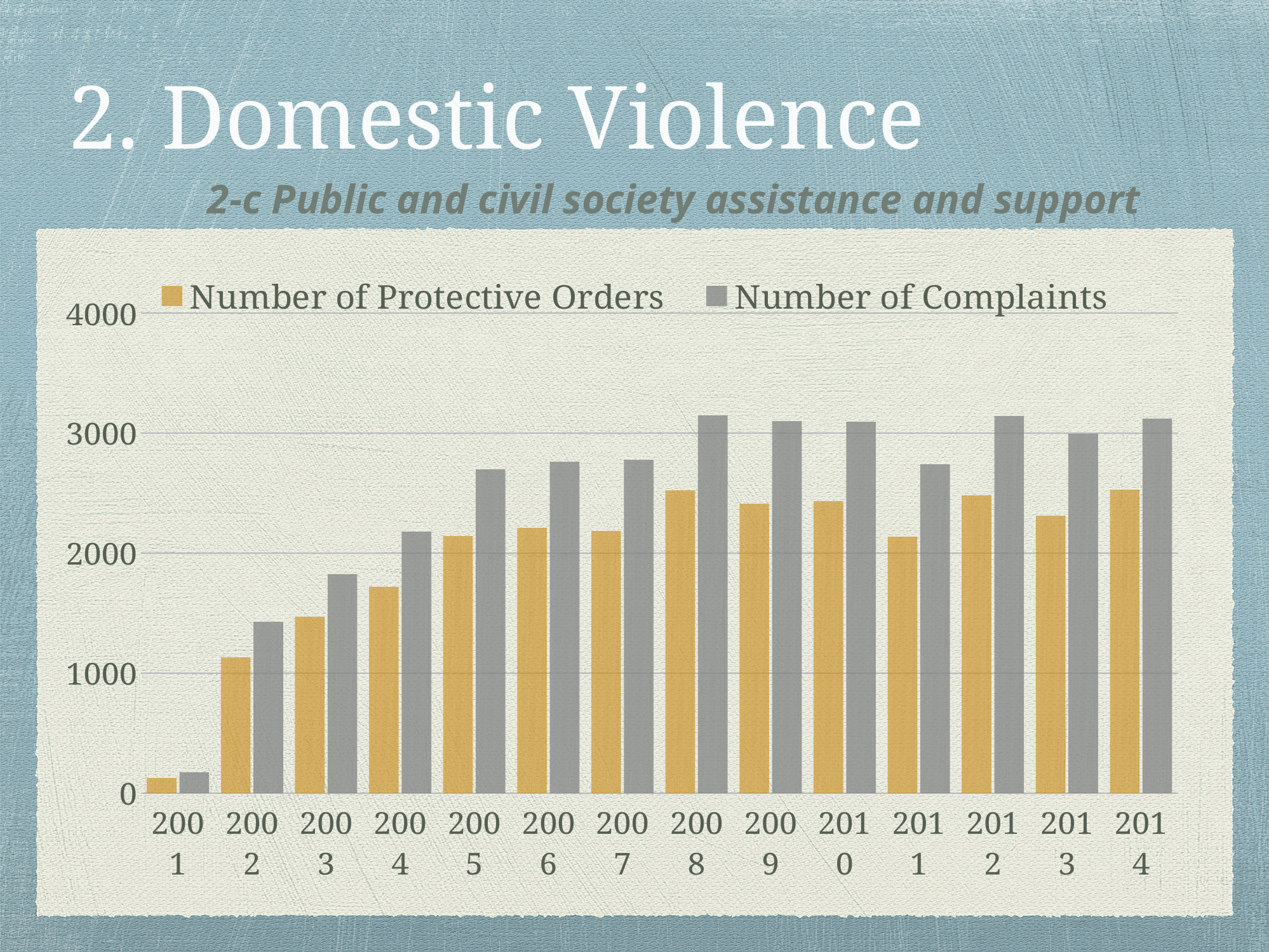
Which year has the lowest Number of Protective Orders? 2001 How many years are shown on the x axis? 14 Do the Number of Protective Orders values rise or fall from 2001 to 2005? rise Is the Number of Complaints for 2003 greater or less than 2000? less Is the Number of Protective Orders for 2004 greater or less than 2000? less Is the Number of Protective Orders for 2001 greater or less than 1000? less What kind of chart is shown on the slide? bar chart In 2008, which is larger: the Number of Protective Orders or the Number of Complaints? Number of Complaints How many series does the legend list? 2 Which year has the lowest Number of Complaints? 2001 Which is larger: the Number of Protective Orders in 2002 or in 2003? 2003